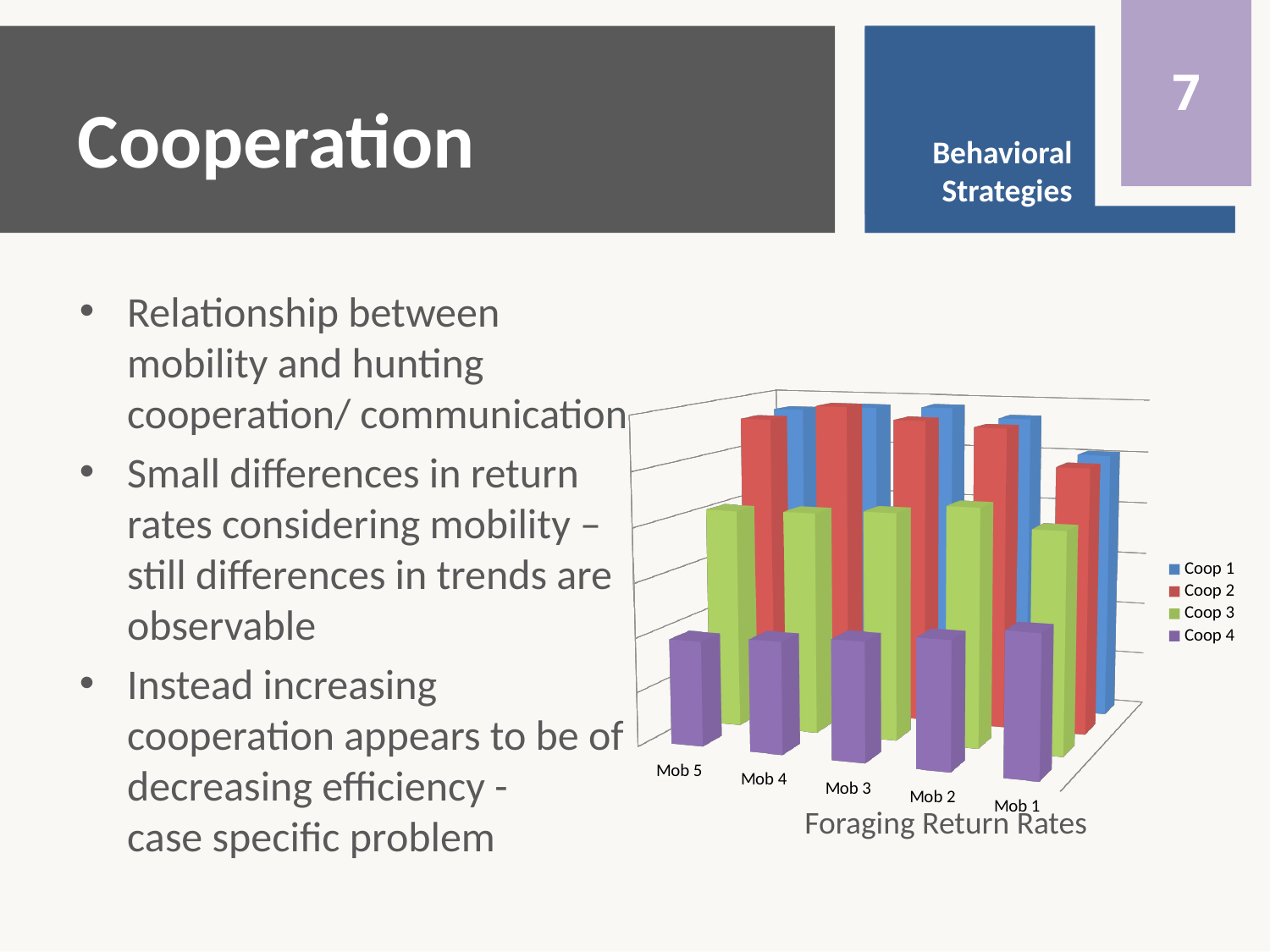
How many series does the chart legend list? 4 What kind of chart is shown on the slide? bar chart Which series is plotted in purple in the chart? Coop 4 For Mob 5, which is larger: the Coop 3 bar or the Coop 4 bar? Coop 3 Which series has the lowest bars across all mobility categories in the chart? Coop 4 How many mobility categories are shown along the x axis of the chart? 5 For Mob 3, which is larger: the Coop 1 bar or the Coop 4 bar? Coop 1 For Mob 1, which is larger: the Coop 2 bar or the Coop 3 bar? Coop 2 Which category label appears at the far left of the chart's x axis? Mob 5 What is the title of the chart? Foraging Return Rates